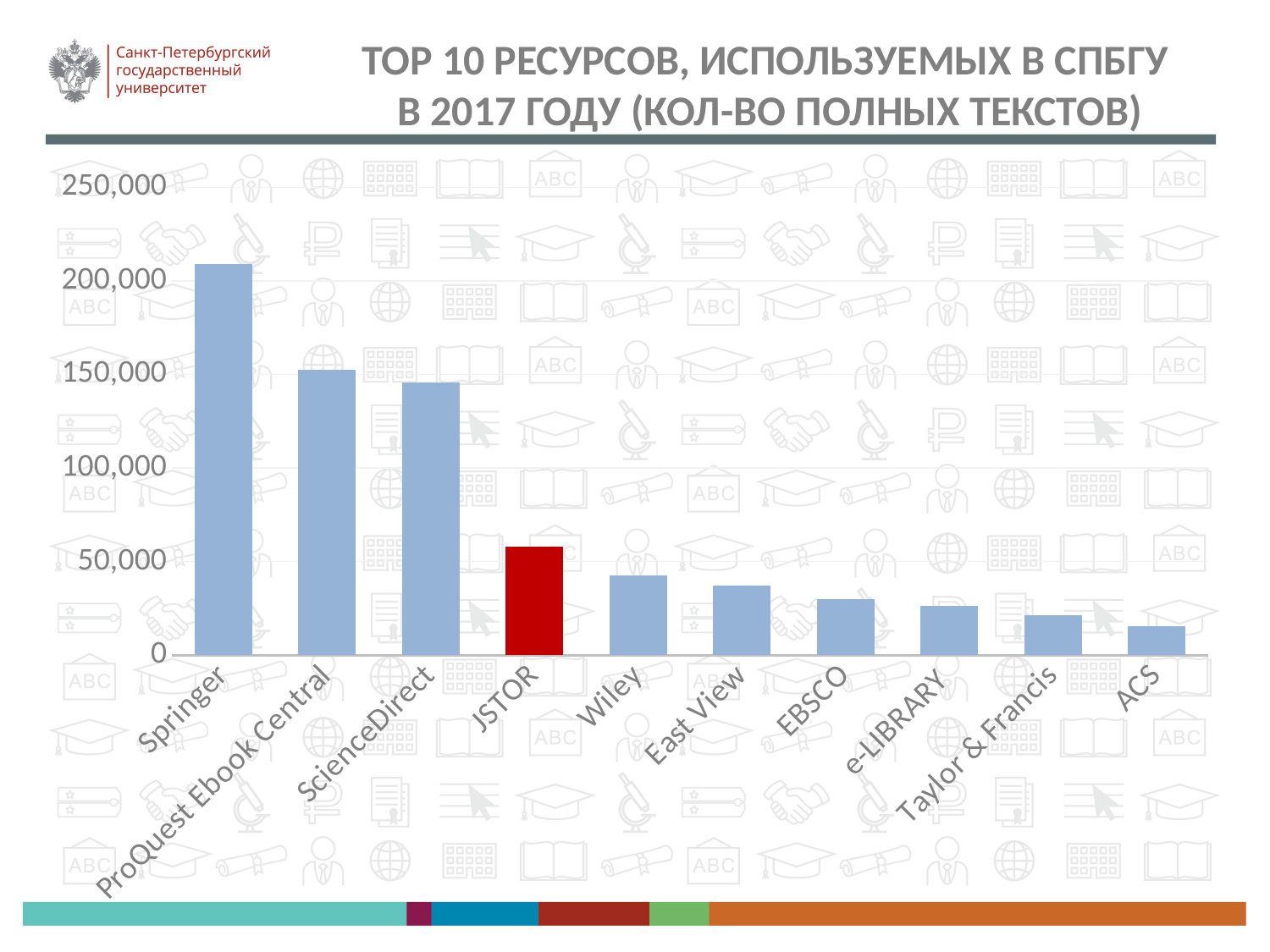
Which resource has the highest number of full texts? Springer How many resources (categories) are shown on the chart? 10 What kind of chart is shown on the slide? bar chart Do the values rise or fall from left to right along the x axis? fall Is the value for Springer greater or less than 200,000? greater Which bar is highlighted in red on the chart? JSTOR Which has a larger value, EBSCO or ACS? EBSCO Is the value for Wiley greater or less than 50,000? less Is the value for ACS greater or less than 50,000? less Which resource has the lowest number of full texts? ACS Which has a larger value, ScienceDirect or JSTOR? ScienceDirect